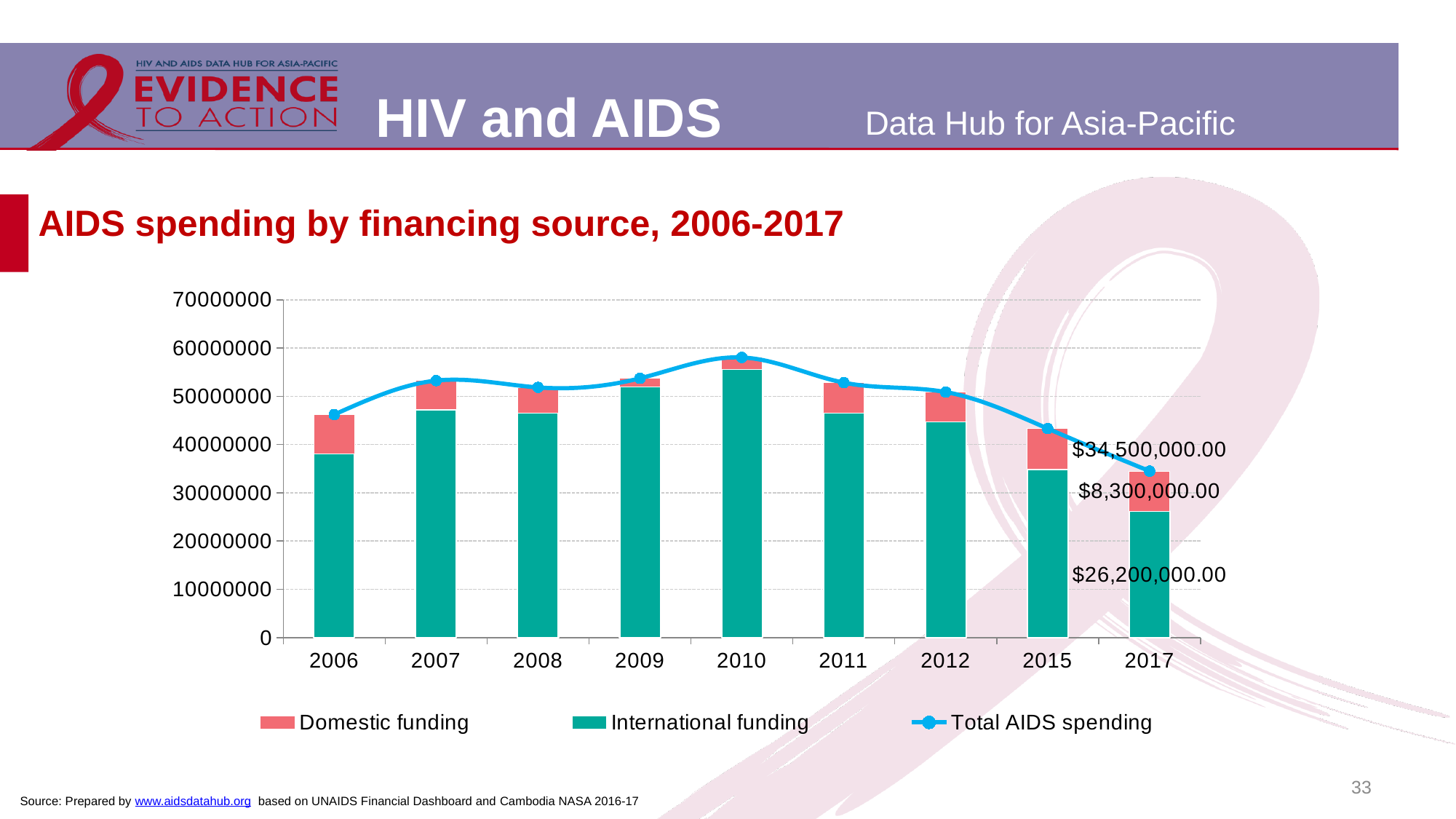
Is the International funding value for 2006 greater or less than 40000000? less How many years are shown on the x axis of the chart? 9 Does Total AIDS spending rise or fall from 2010 to 2017? Fall How many series does the chart's legend list? 3 In 2017, how much larger is International funding than Domestic funding? $17,900,000.00 In which year is Total AIDS spending highest? 2010 What is the Domestic funding value labelled for 2017? $8,300,000.00 In which year is Total AIDS spending lowest? 2017 What kind of chart is shown on the slide? A stacked bar chart with a line What is the International funding value labelled for 2017? $26,200,000.00 What is the Total AIDS spending value labelled for 2017? $34,500,000.00 Which year has the larger International funding, 2006 or 2010? 2010